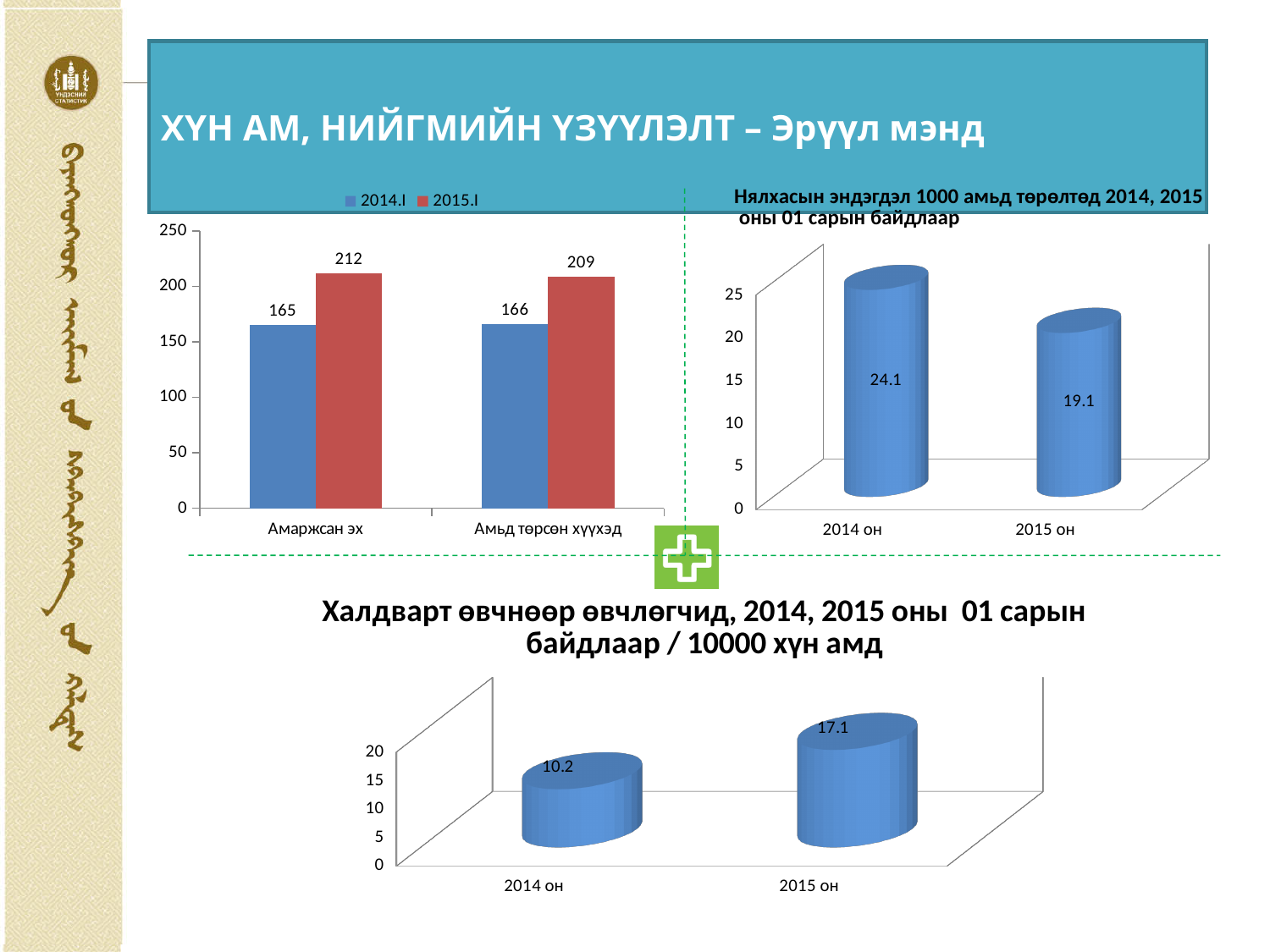
In the chart titled 'Нялхасын эндэгдэл 1000 амьд төрөлтөд 2014, 2015 оны 01 сарын байдлаар', do the values rise or fall from 2014 он to 2015 он? Fall In the chart titled 'Нялхасын эндэгдэл 1000 амьд төрөлтөд 2014, 2015 оны 01 сарын байдлаар', what is the value for 2014 он? 24.1 How many categories are shown on the x axis of the bottom chart? 2 In the top-left chart, how many series does the legend list? 2 In the chart titled 'Халдварт өвчнөөр өвчлөгчид, 2014, 2015 оны 01 сарын байдлаар / 10000 хүн амд', what is the difference between the 2015 он and 2014 он values? 6.9 In the chart titled 'Нялхасын эндэгдэл 1000 амьд төрөлтөд 2014, 2015 оны 01 сарын байдлаар', which year has the lowest value? 2015 он In the top-left chart, what colour are the 2015.I bars? Red In the top-left chart, what is the value for Амьд төрсөн хүүхэд in the 2015.I series? 209 In the top-left chart, what is the value for Амаржсан эх in the 2014.I series? 165 In the chart titled 'Халдварт өвчнөөр өвчлөгчид, 2014, 2015 оны 01 сарын байдлаар / 10000 хүн амд', what is the value for 2015 он? 17.1 In the top-left chart, which series has the larger value for Амьд төрсөн хүүхэд, 2014.I or 2015.I? 2015.I In the top-left chart, what is the difference between the 2015.I and 2014.I values for Амаржсан эх? 47